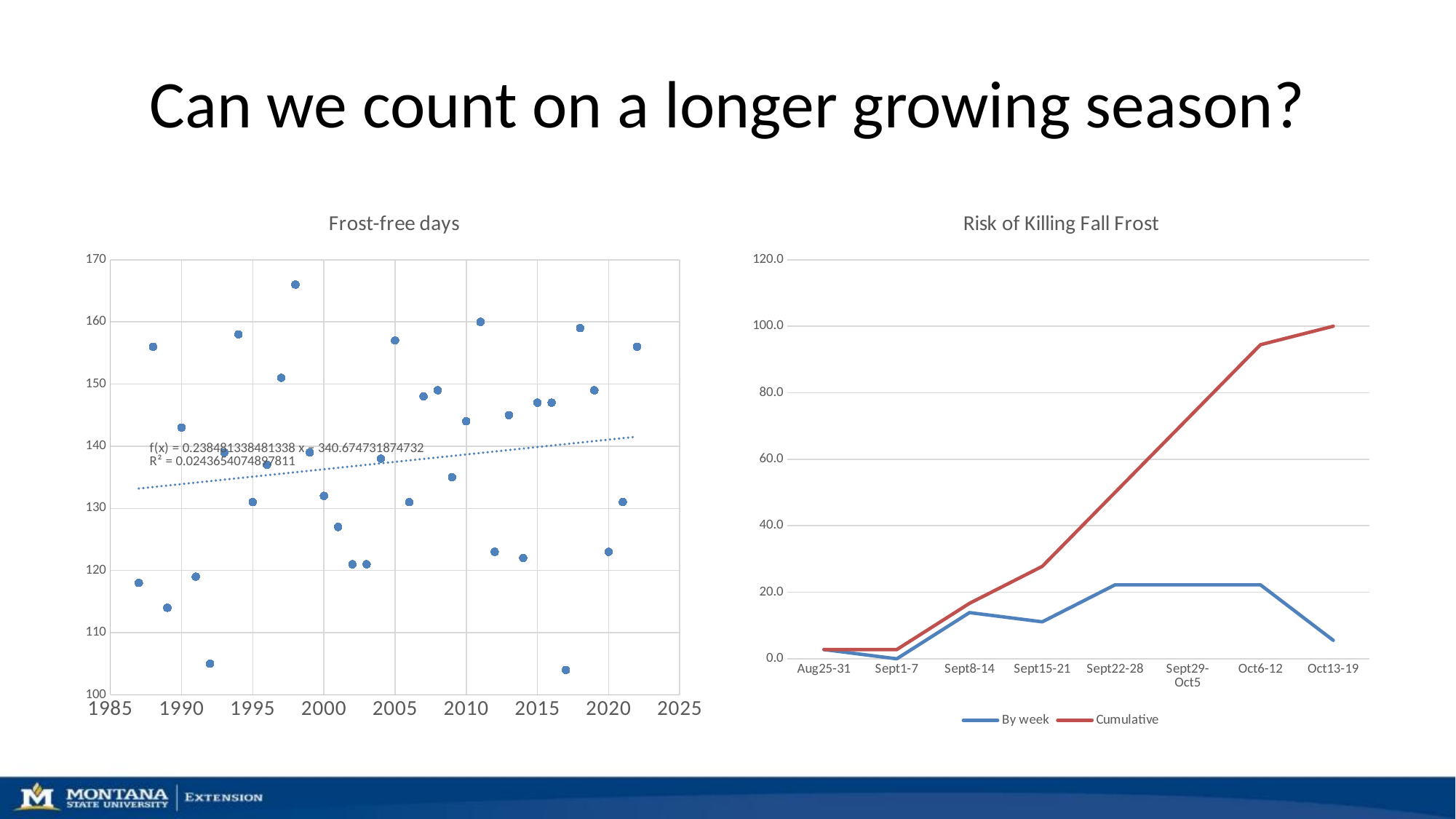
In the 'Risk of Killing Fall Frost' chart, how many series does the legend list? 2 In the 'Risk of Killing Fall Frost' chart, is the Cumulative value for Oct6-12 greater or less than 80.0? greater In the 'Risk of Killing Fall Frost' chart, which series is higher at Oct6-12, By week or Cumulative? Cumulative What kind of chart is the 'Frost-free days' chart on the left? scatter chart In the 'Risk of Killing Fall Frost' chart, is the By week value for Oct13-19 greater or less than 20.0? less In the 'Risk of Killing Fall Frost' chart, what are the two legend entries? By week, Cumulative In the 'Frost-free days' chart, is the highest plotted value greater or less than 160? greater In the 'Frost-free days' chart, does the dotted trendline slope upward or downward across the years? upward What kind of chart is the 'Risk of Killing Fall Frost' chart on the right? line chart In the 'Risk of Killing Fall Frost' chart, how many week categories are shown on the x axis? 8 In the 'Risk of Killing Fall Frost' chart, does the Cumulative series rise or fall from Aug25-31 to Oct13-19? rise